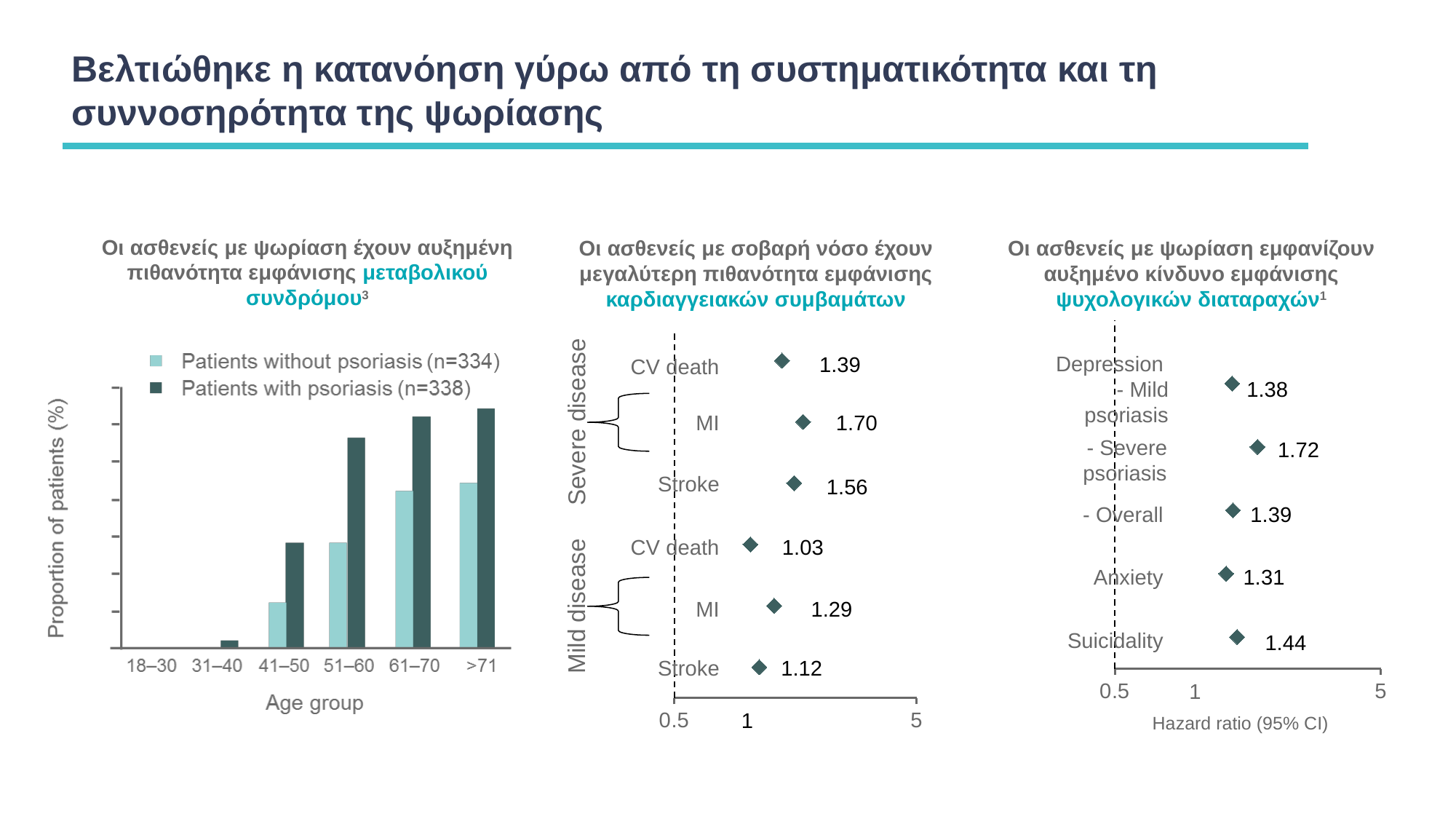
In the right chart (psychological disorders), which category has the highest hazard ratio? Depression - Severe psoriasis In the middle chart (cardiovascular events), what is the difference between the hazard ratio for stroke in severe disease and stroke in mild disease? 0.44 How many age groups are shown on the x axis of the left bar chart? 6 How many series does the legend of the left bar chart list? 2 In the left bar chart, which age group has the highest proportion of patients with psoriasis? >71 What kind of chart is the left chart (Proportion of patients by age group)? bar chart In the right chart (psychological disorders), what is the hazard ratio for suicidality? 1.44 In the left bar chart, do the values for patients with psoriasis rise or fall as age group increases? rise In the middle chart (cardiovascular events), which outcome has the lowest hazard ratio? CV death (mild disease) In the middle chart (cardiovascular events), what is the hazard ratio for MI in severe disease? 1.70 In the right chart (psychological disorders), what is the x-axis label? Hazard ratio (95% CI) In the left bar chart, for the 61–70 age group, which is larger: patients with psoriasis or patients without psoriasis? Patients with psoriasis